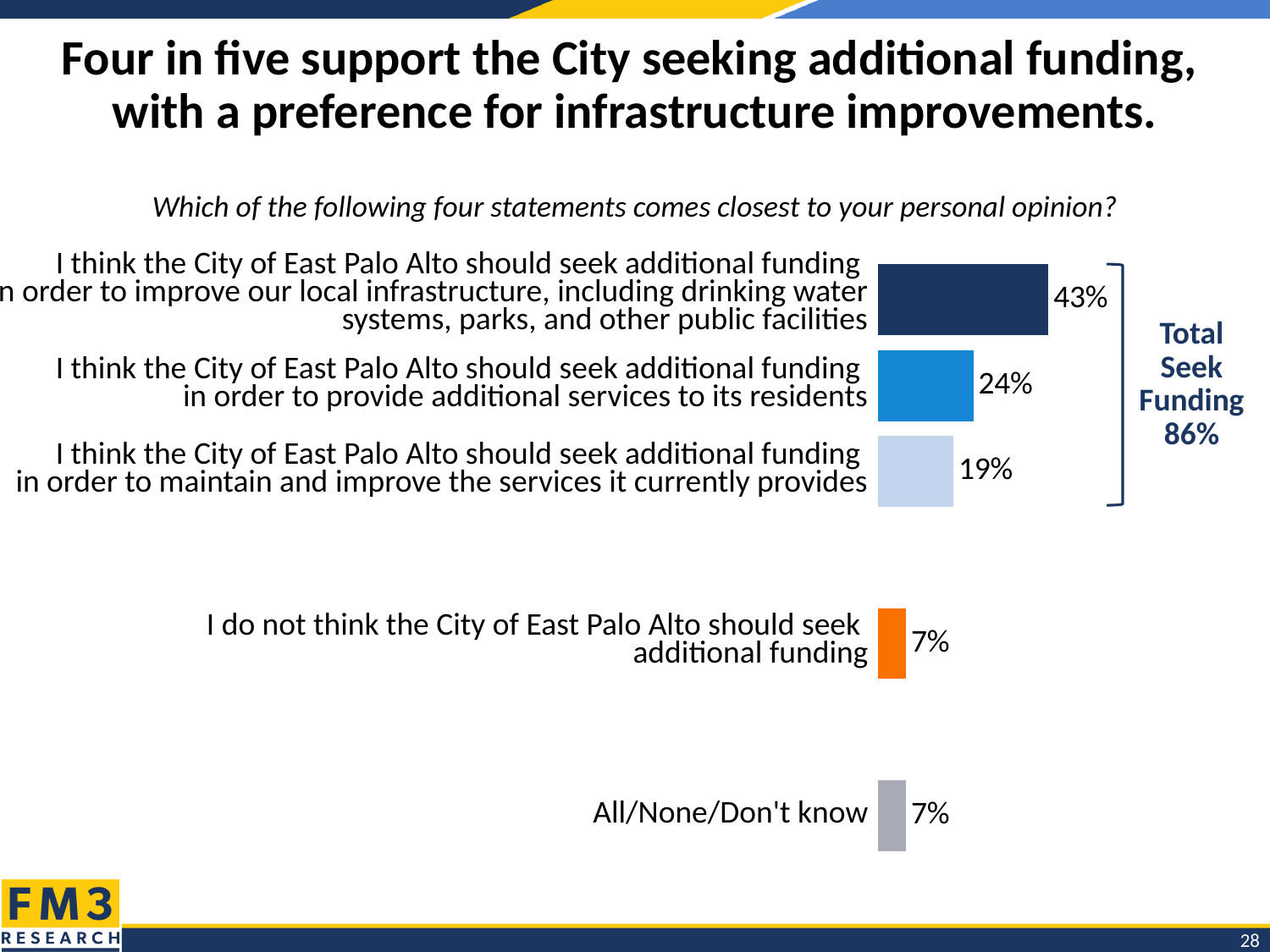
What percentage of respondents think the City should seek additional funding to improve local infrastructure? 43% What percentage do not think the City of East Palo Alto should seek additional funding? 7% How many response categories are plotted in the chart? 5 What is the difference in percentage points between the infrastructure statement and the additional services statement? 19 What percentage chose the statement about seeking additional funding to provide additional services to residents? 24% What type of chart is shown on the slide? Bar chart Which statement received the highest share of responses? Seek additional funding to improve local infrastructure What is the Total Seek Funding percentage shown on the slide? 86% Which is larger: the share for providing additional services or the share for maintaining and improving current services? Providing additional services What percentage answered All/None/Don't know? 7% What survey question is shown above the chart? Which of the following four statements comes closest to your personal opinion? What percentage chose the statement about seeking additional funding to maintain and improve current services? 19%